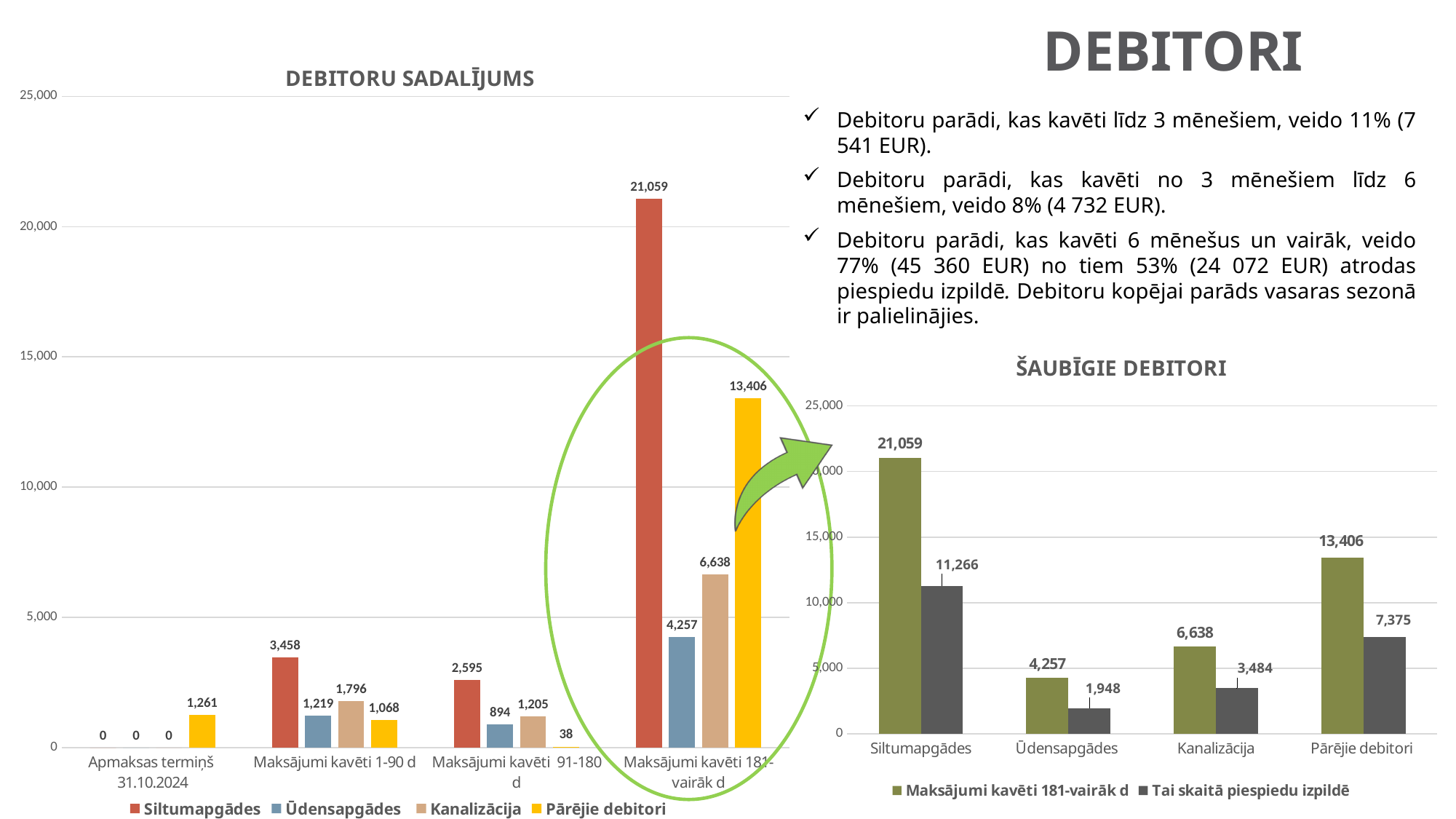
In the ŠAUBĪGIE DEBITORI chart, what is the difference between Maksājumi kavēti 181-vairāk d and Tai skaitā piespiedu izpildē for Pārējie debitori? 6,031 In the DEBITORU SADALĪJUMS chart, how many categories are shown on the x axis? 4 What kind of chart is the ŠAUBĪGIE DEBITORI chart? bar chart In the DEBITORU SADALĪJUMS chart, how many series does the legend list? 4 In the ŠAUBĪGIE DEBITORI chart, which category has the highest value for Maksājumi kavēti 181-vairāk d? Siltumapgādes In the DEBITORU SADALĪJUMS chart, what is the value for Pārējie debitori in the Maksājumi kavēti 91-180 d category? 38 In the ŠAUBĪGIE DEBITORI chart, what is the value of Tai skaitā piespiedu izpildē for Kanalizācija? 3,484 In the DEBITORU SADALĪJUMS chart, what is the value for Kanalizācija in the Maksājumi kavēti 1-90 d category? 1,796 In the DEBITORU SADALĪJUMS chart, what is the difference between Siltumapgādes and Ūdensapgādes in the Maksājumi kavēti 1-90 d category? 2,239 In the DEBITORU SADALĪJUMS chart, which series has the lowest value in the Maksājumi kavēti 91-180 d category? Pārējie debitori In the DEBITORU SADALĪJUMS chart, what is the value for Siltumapgādes in the Maksājumi kavēti 181-vairāk d category? 21,059 In the ŠAUBĪGIE DEBITORI chart, is the value of Tai skaitā piespiedu izpildē for Siltumapgādes greater or less than 10,000? greater